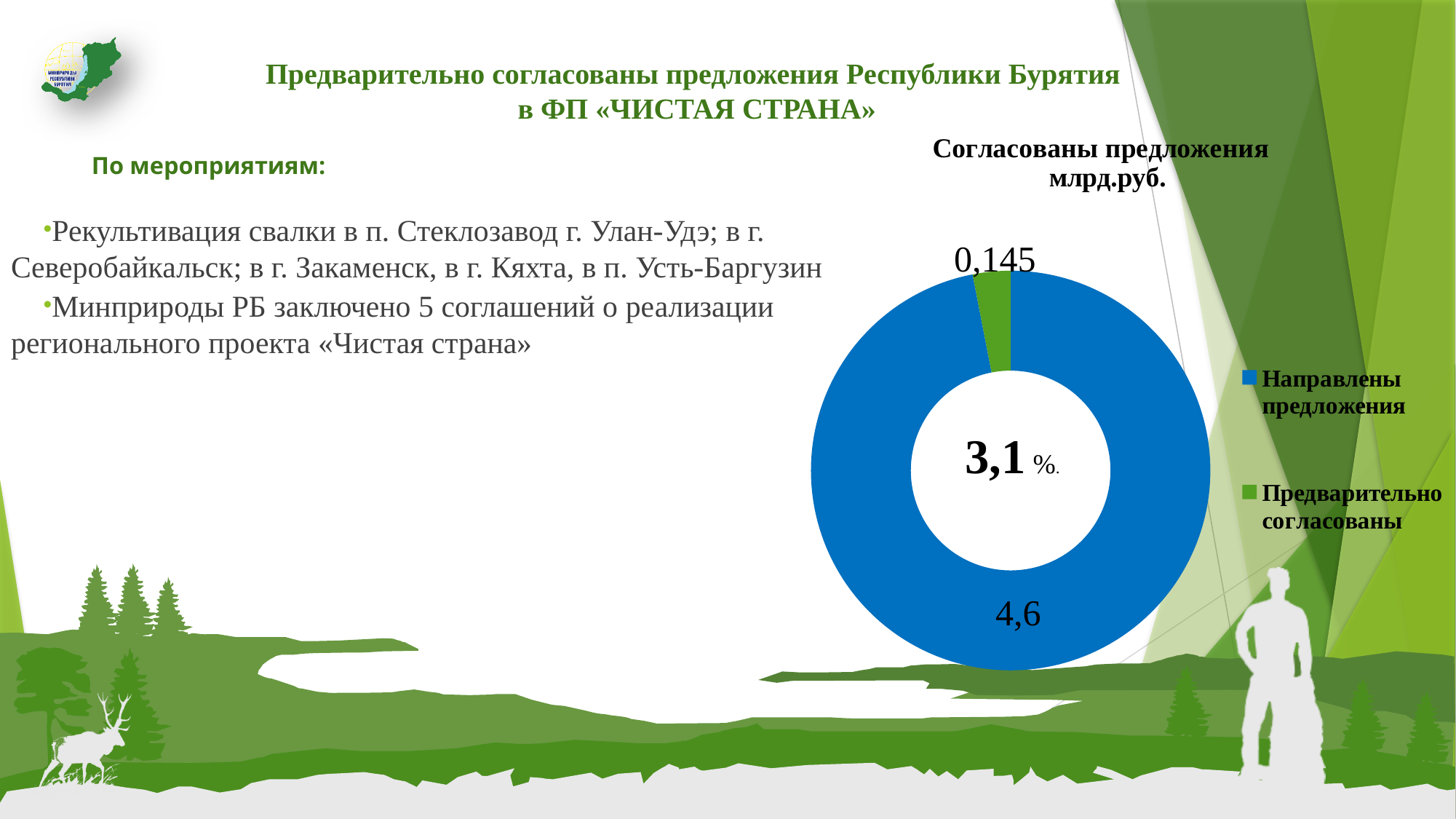
How many entries does the legend of the chart list? 2 Which category has the largest value in the chart «Согласованы предложения млрд.руб.»? Направлены предложения Which category has the smallest value in the chart «Согласованы предложения млрд.руб.»? Предварительно согласованы Which is larger in the chart: «Направлены предложения» or «Предварительно согласованы»? Направлены предложения What is the value for «Предварительно согласованы» in the chart «Согласованы предложения млрд.руб.»? 0,145 How many categories does the chart «Согласованы предложения млрд.руб.» show? 2 What is the difference between the values for «Направлены предложения» and «Предварительно согласованы» in the chart? 4,455 What is the value for «Направлены предложения» in the chart «Согласованы предложения млрд.руб.»? 4,6 What percentage is printed in the centre of the doughnut chart? 3,1 % What colour represents «Предварительно согласованы» in the chart? green What kind of chart is shown on the slide? doughnut chart What is the total of the two values shown in the chart «Согласованы предложения млрд.руб.»? 4,745